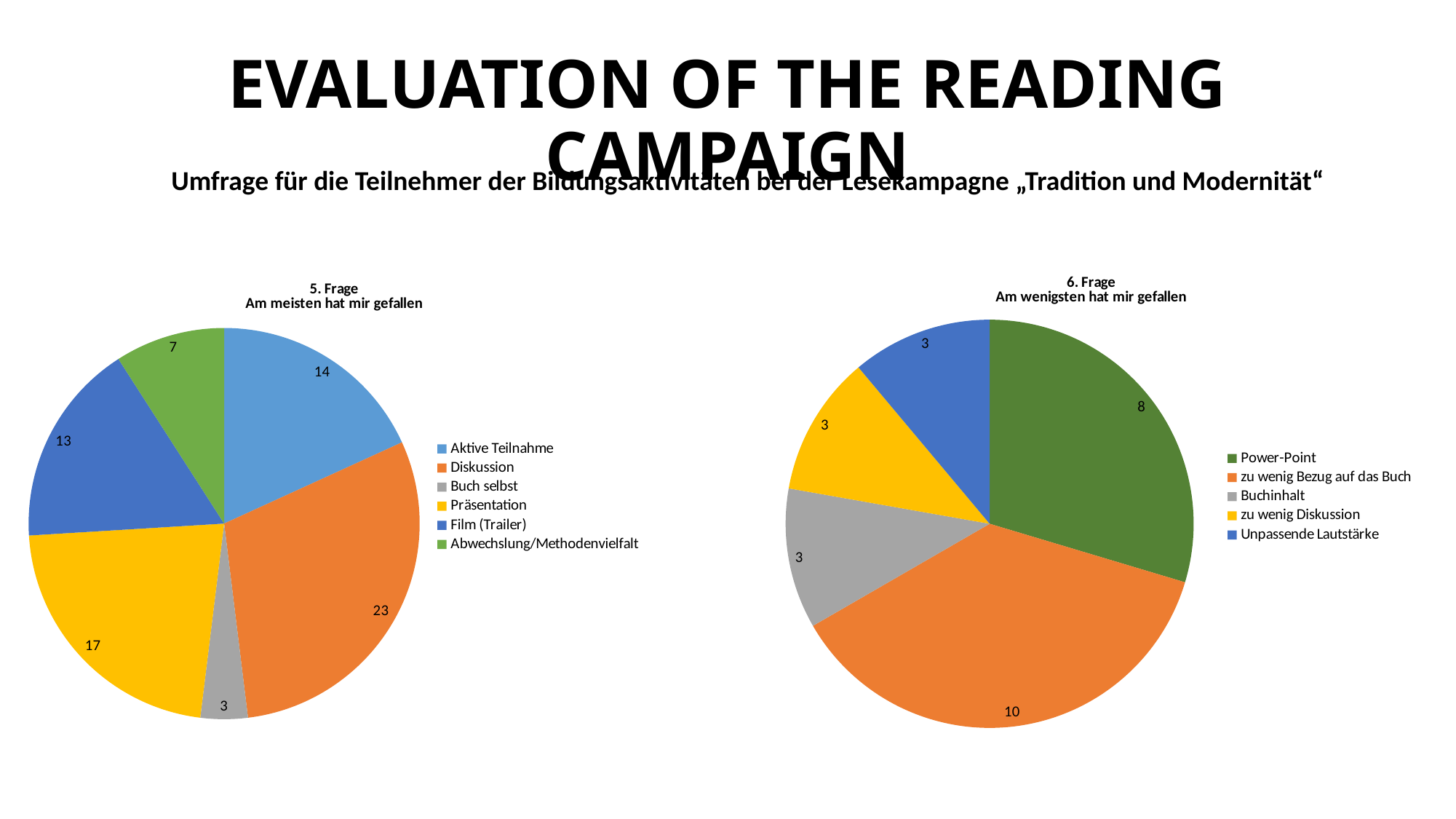
In the chart titled "5. Frage Am meisten hat mir gefallen", how many categories does the legend list? 6 In the chart titled "5. Frage Am meisten hat mir gefallen", what is the difference between the values for Präsentation and Aktive Teilnahme? 3 In the chart titled "5. Frage Am meisten hat mir gefallen", which category has the lowest value? Buch selbst In the chart titled "6. Frage Am wenigsten hat mir gefallen", what colour is the slice for Unpassende Lautstärke? Blue In the chart titled "6. Frage Am wenigsten hat mir gefallen", which category has the highest value? zu wenig Bezug auf das Buch In the chart titled "5. Frage Am meisten hat mir gefallen", what is the value for Film (Trailer)? 13 In the chart titled "5. Frage Am meisten hat mir gefallen", what is the value for Diskussion? 23 What kind of chart is the chart titled "6. Frage Am wenigsten hat mir gefallen"? Pie chart In the chart titled "6. Frage Am wenigsten hat mir gefallen", which is larger: the value for Power-Point or the value for Buchinhalt? Power-Point In the chart titled "6. Frage Am wenigsten hat mir gefallen", what is the value for Power-Point? 8 In the chart titled "5. Frage Am meisten hat mir gefallen", which category has the highest value? Diskussion In the chart titled "6. Frage Am wenigsten hat mir gefallen", what is the difference between the values for zu wenig Bezug auf das Buch and Power-Point? 2